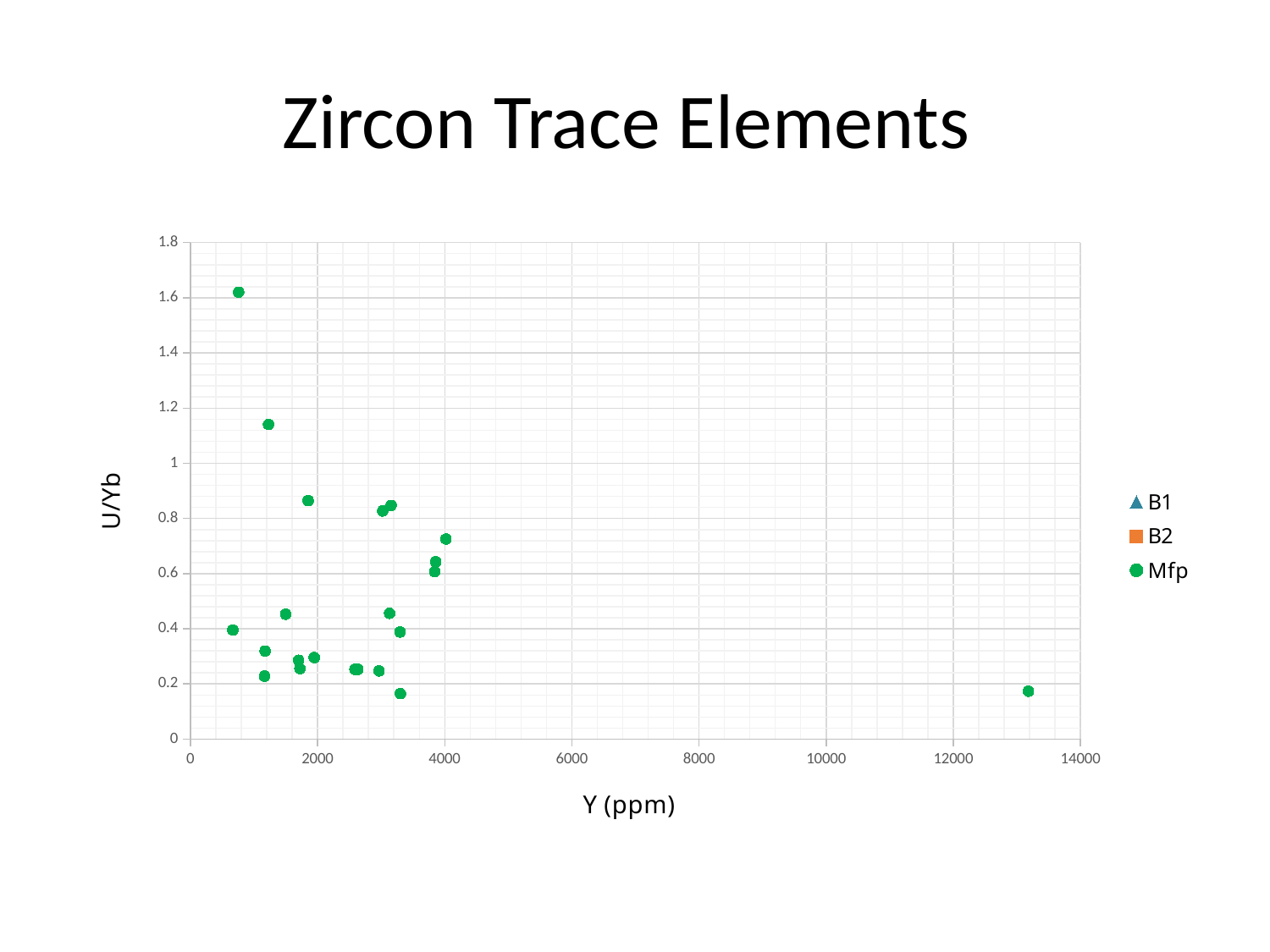
What is the title of the chart? Zircon Trace Elements Are all points other than the rightmost one plotted at Y (ppm) values less than 6000? yes What kind of chart is shown on the slide? scatter chart What is the label of the x axis? Y (ppm) How many series does the legend list? 3 Is the U/Yb value of the second-highest point greater or less than 1? greater Is the Y (ppm) value of the point with the highest U/Yb greater or less than 2000? less